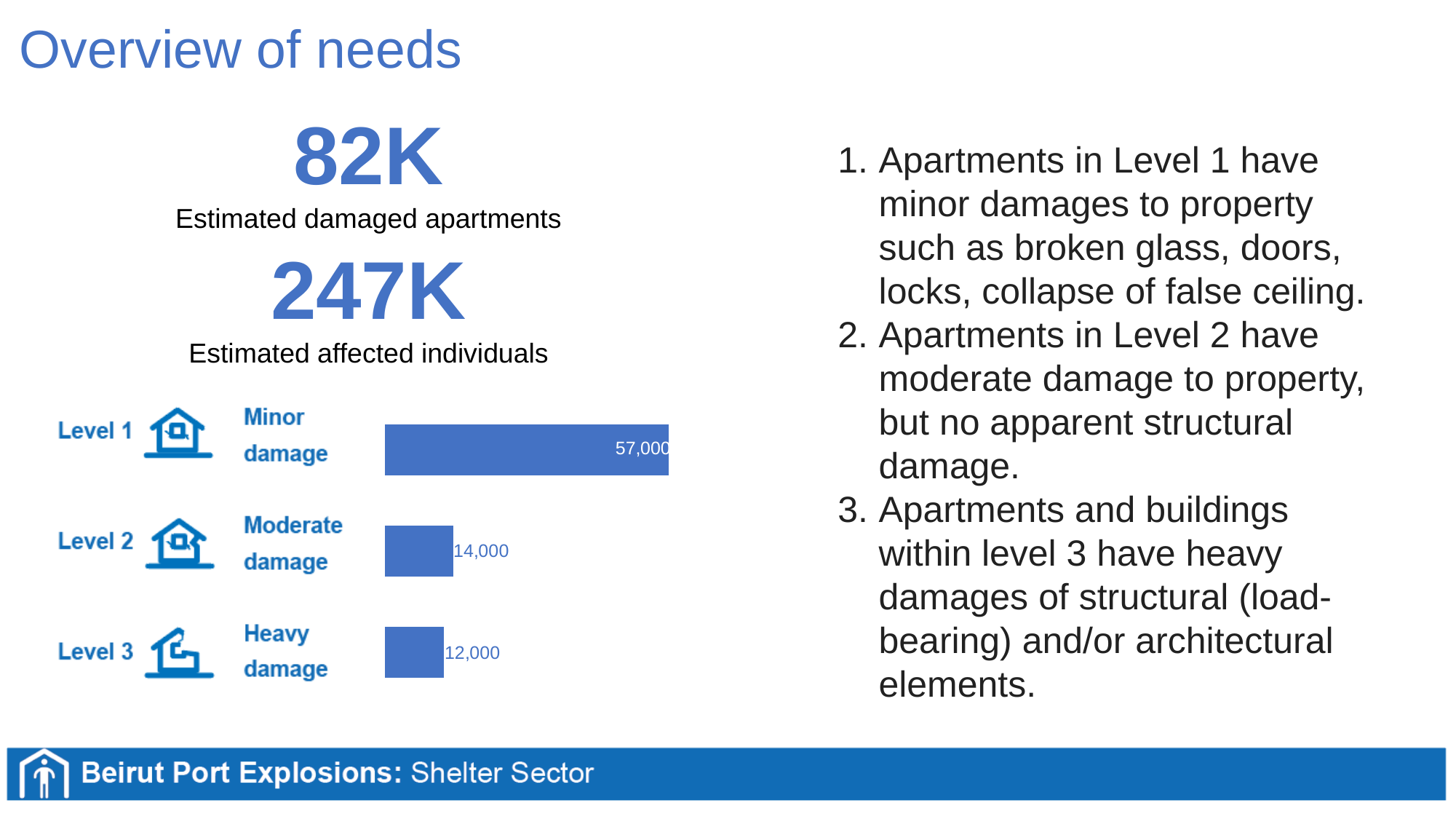
Which damage level has the highest value in the bar chart? Level 1 (Minor damage) Which is larger in the bar chart, the value for Level 2 or the value for Level 3? Level 2 What kind of chart is used to show the damage levels? Bar chart What is the total of the three damage level values in the bar chart? 83,000 Which damage level has the lowest value in the bar chart? Level 3 (Heavy damage) What is the difference between the Level 1 and Level 2 values in the bar chart? 43,000 What is the difference between the Level 2 and Level 3 values in the bar chart? 2,000 What is the value for Level 3 (Heavy damage) in the bar chart? 12,000 What is the value for Level 1 (Minor damage) in the bar chart? 57,000 What is the value for Level 2 (Moderate damage) in the bar chart? 14,000 How many damage levels are shown in the bar chart? 3 What colour are the bars in the damage level chart? Blue